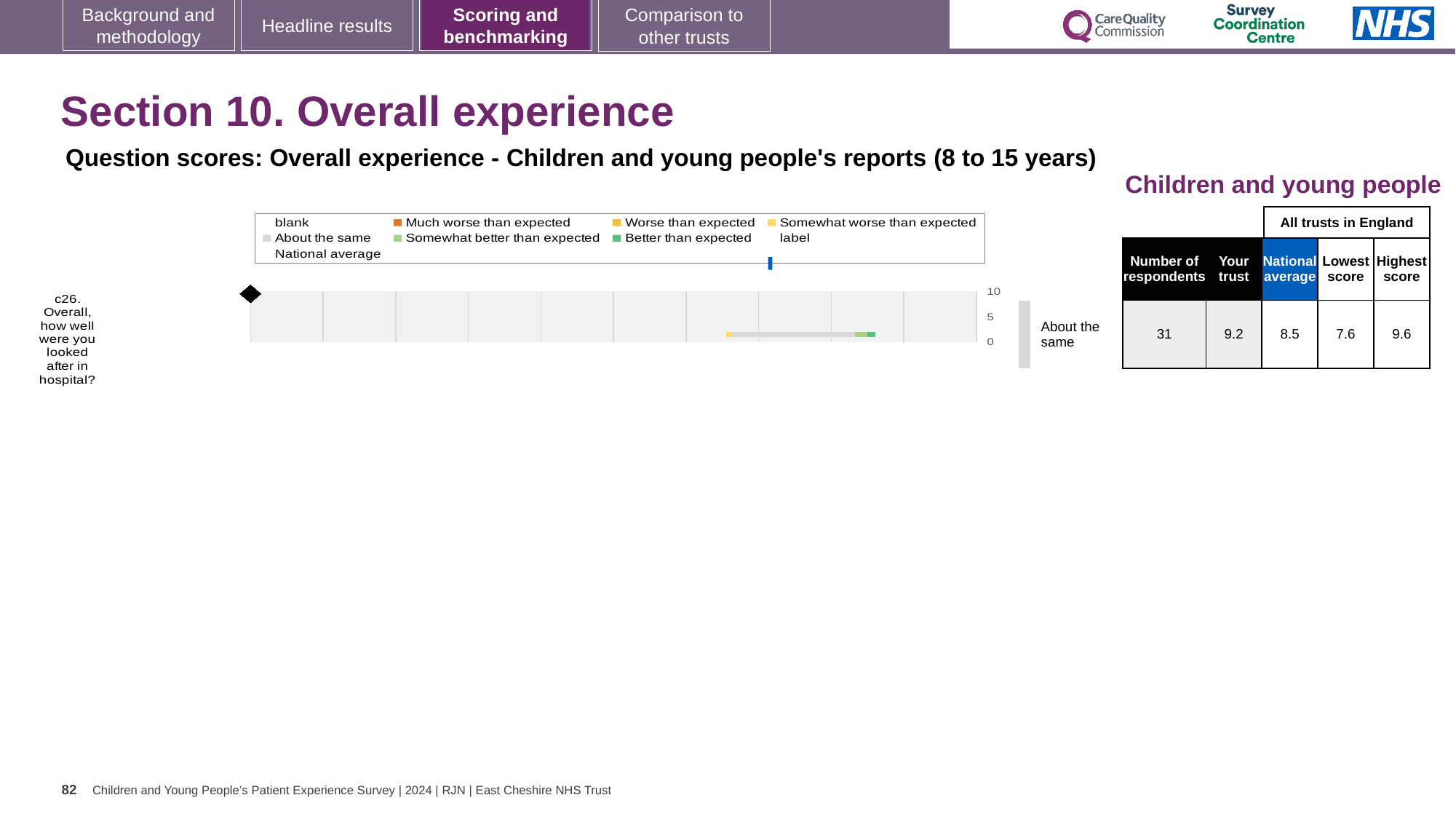
What is the maximum value shown on the chart's score axis? 10 By how much does the 'Your trust' score for c26 exceed the national average? 0.7 How many survey questions are plotted on the chart? 1 What is the lowest score among all trusts in England for c26? 7.6 What is the highest score among all trusts in England for c26? 9.6 What is the difference between the highest and lowest trust scores for c26? 2.0 How many respondents answered question c26? 31 Which is higher for c26: the 'Your trust' score or the national average? Your trust What benchmark category is shown next to the chart for c26? About the same What kind of chart is used to show the question score for c26? Bar chart What is the national average score for c26? 8.5 What is the 'Your trust' score for c26 (Overall, how well were you looked after in hospital?)? 9.2